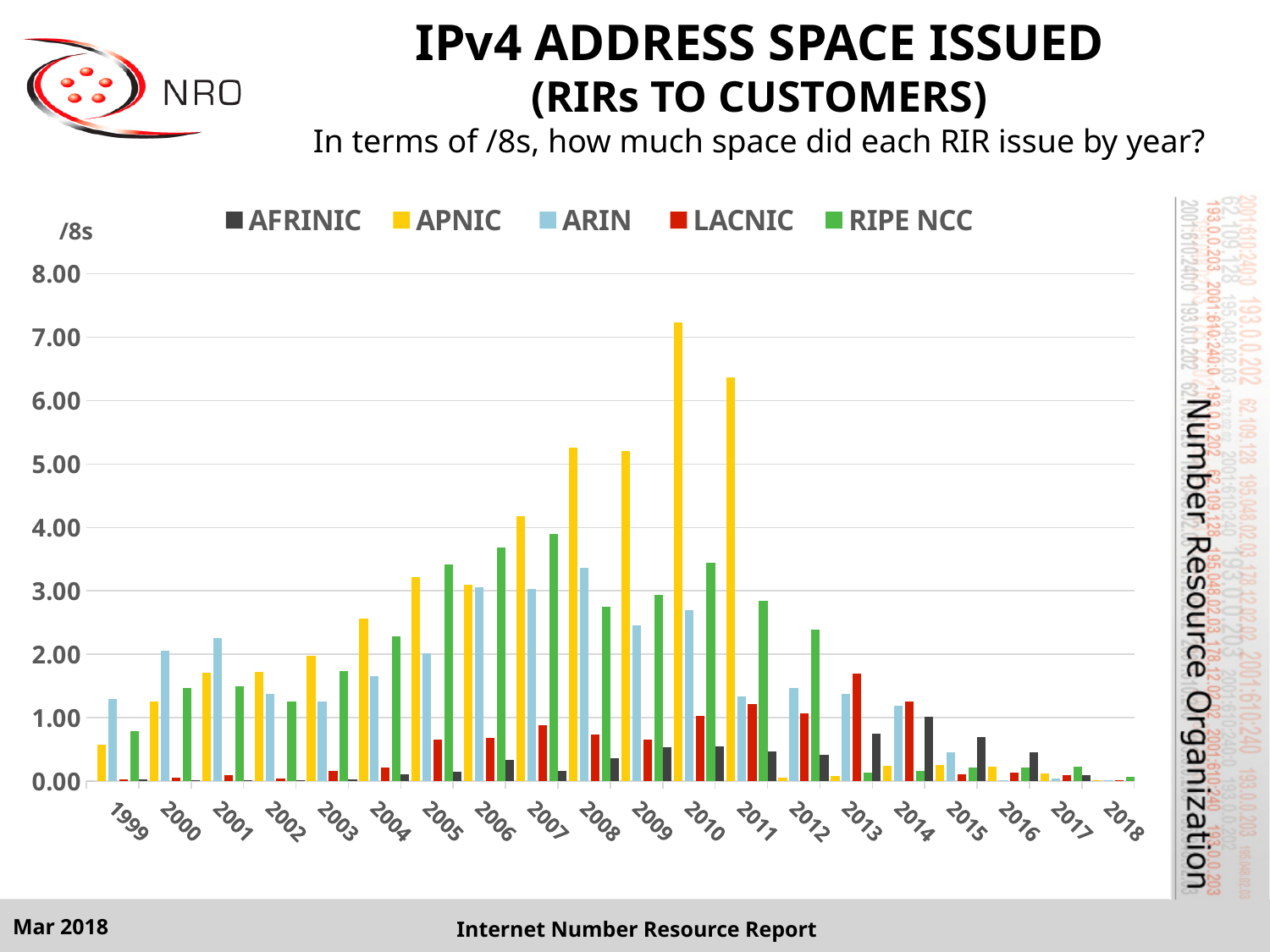
How many years are shown along the x axis? 20 Is the value for RIPE NCC in 2007 greater or less than 4.00? less Is the value for APNIC in 2011 greater or less than 6.00? greater How many series does the legend list? 5 Which RIR issued the most IPv4 address space in 2013? LACNIC In 2000, which issued more IPv4 address space, ARIN or RIPE NCC? ARIN In 2010, which issued more IPv4 address space, APNIC or RIPE NCC? APNIC Is the value for APNIC in 2010 greater or less than 7.00? greater What kind of chart is shown on the slide? bar chart In which year did APNIC issue the most IPv4 address space? 2010 Does the APNIC value rise or fall from 2011 to 2018? fall